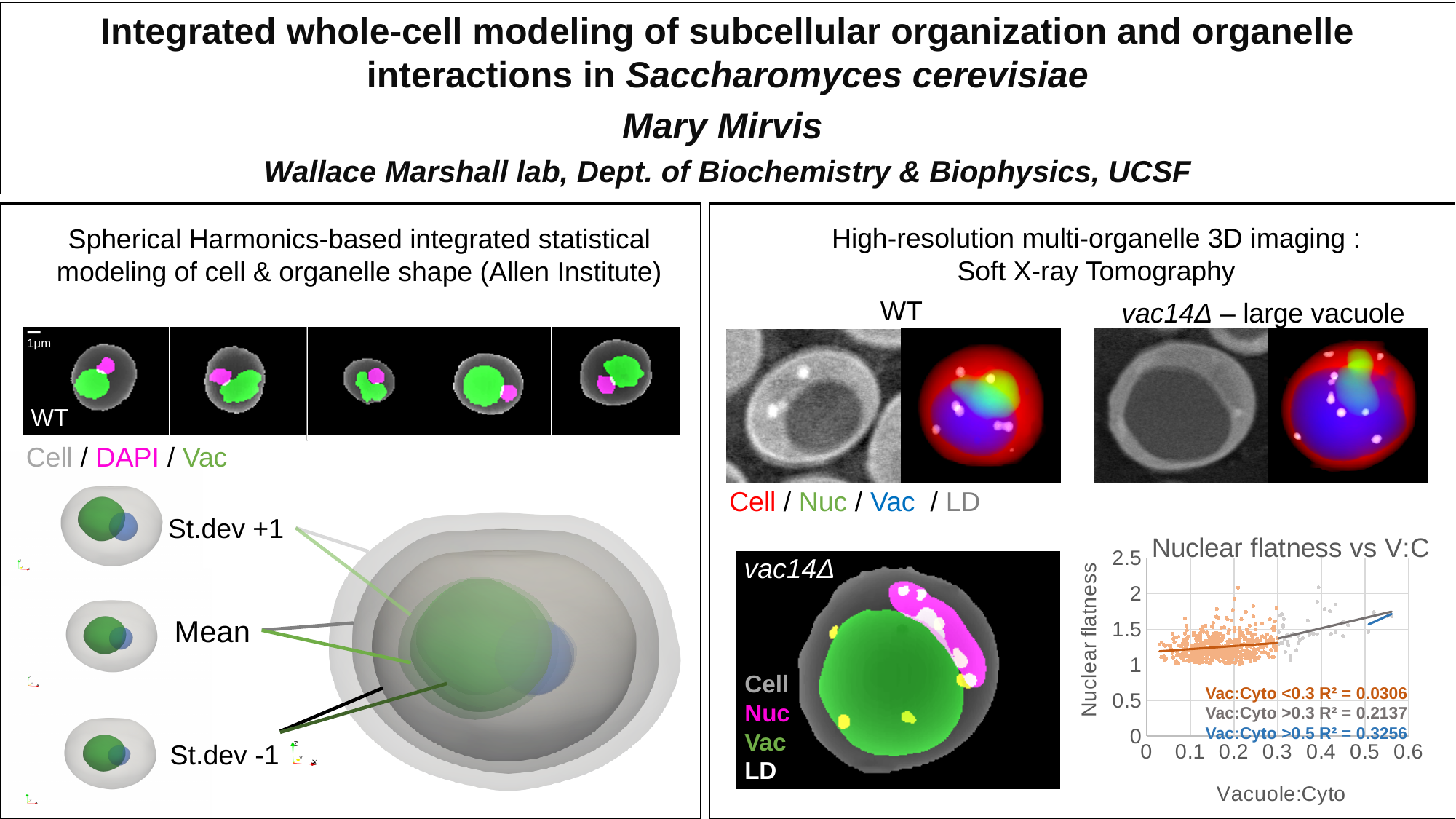
In the "Nuclear flatness vs V:C" chart, what is the highest tick value shown on the y axis? 2.5 What kind of chart is "Nuclear flatness vs V:C"? scatter plot In the "Nuclear flatness vs V:C" chart, what is the difference between the R² values for Vac:Cyto >0.5 and Vac:Cyto >0.3? 0.1119 In the "Nuclear flatness vs V:C" chart, does nuclear flatness generally rise or fall as Vacuole:Cyto increases? rise In the "Nuclear flatness vs V:C" chart, is the R² for Vac:Cyto >0.3 larger or smaller than the R² for Vac:Cyto <0.3? larger In the "Nuclear flatness vs V:C" chart, which Vac:Cyto group has the lowest R² value? Vac:Cyto <0.3 In the "Nuclear flatness vs V:C" chart, what is the label of the x axis? Vacuole:Cyto What is the title of the chart in the lower right of the slide? Nuclear flatness vs V:C In the "Nuclear flatness vs V:C" chart, what R² value is given for Vac:Cyto >0.3? 0.2137 In the "Nuclear flatness vs V:C" chart, what R² value is given for Vac:Cyto >0.5? 0.3256 In the "Nuclear flatness vs V:C" chart, what R² value is given for Vac:Cyto <0.3? 0.0306 In the "Nuclear flatness vs V:C" chart, which Vac:Cyto group has the highest R² value? Vac:Cyto >0.5